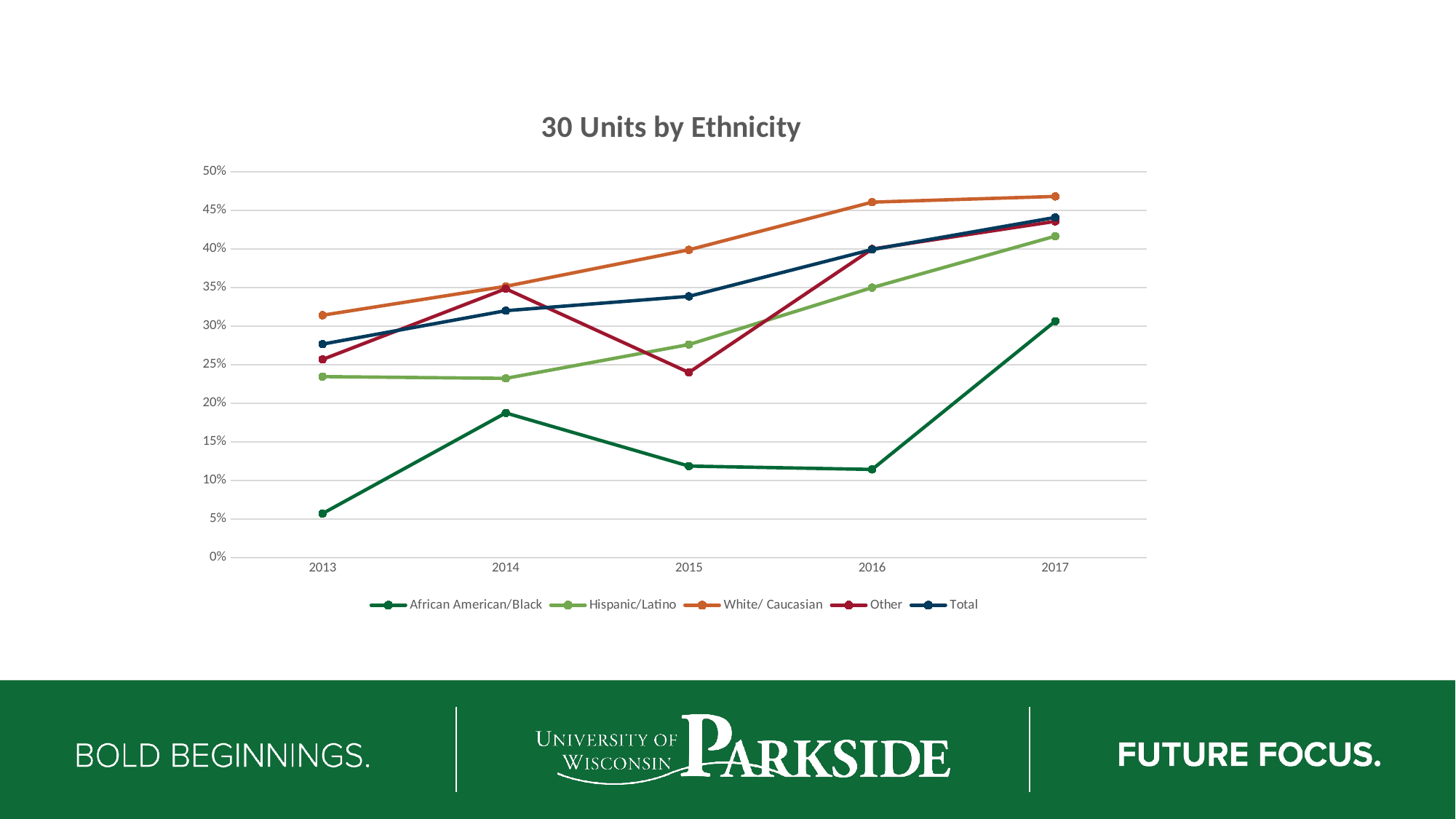
Is the value for White/ Caucasian in 2016 greater or less than 40%? greater Which series has the lowest value in 2013? African American/Black Is the value for African American/Black in 2013 greater or less than 10%? less What kind of chart is shown on the slide? line chart How many years are shown on the x axis? 5 Is the value for Total in 2015 greater or less than 30%? greater Does the White/ Caucasian series rise or fall from 2013 to 2017? rises Which series has the highest value in 2017? White/ Caucasian How many series does the legend list? 5 In 2015, which is higher: Hispanic/Latino or Other? Hispanic/Latino In which year does the African American/Black series reach its highest value? 2017 What is the title of the chart? 30 Units by Ethnicity